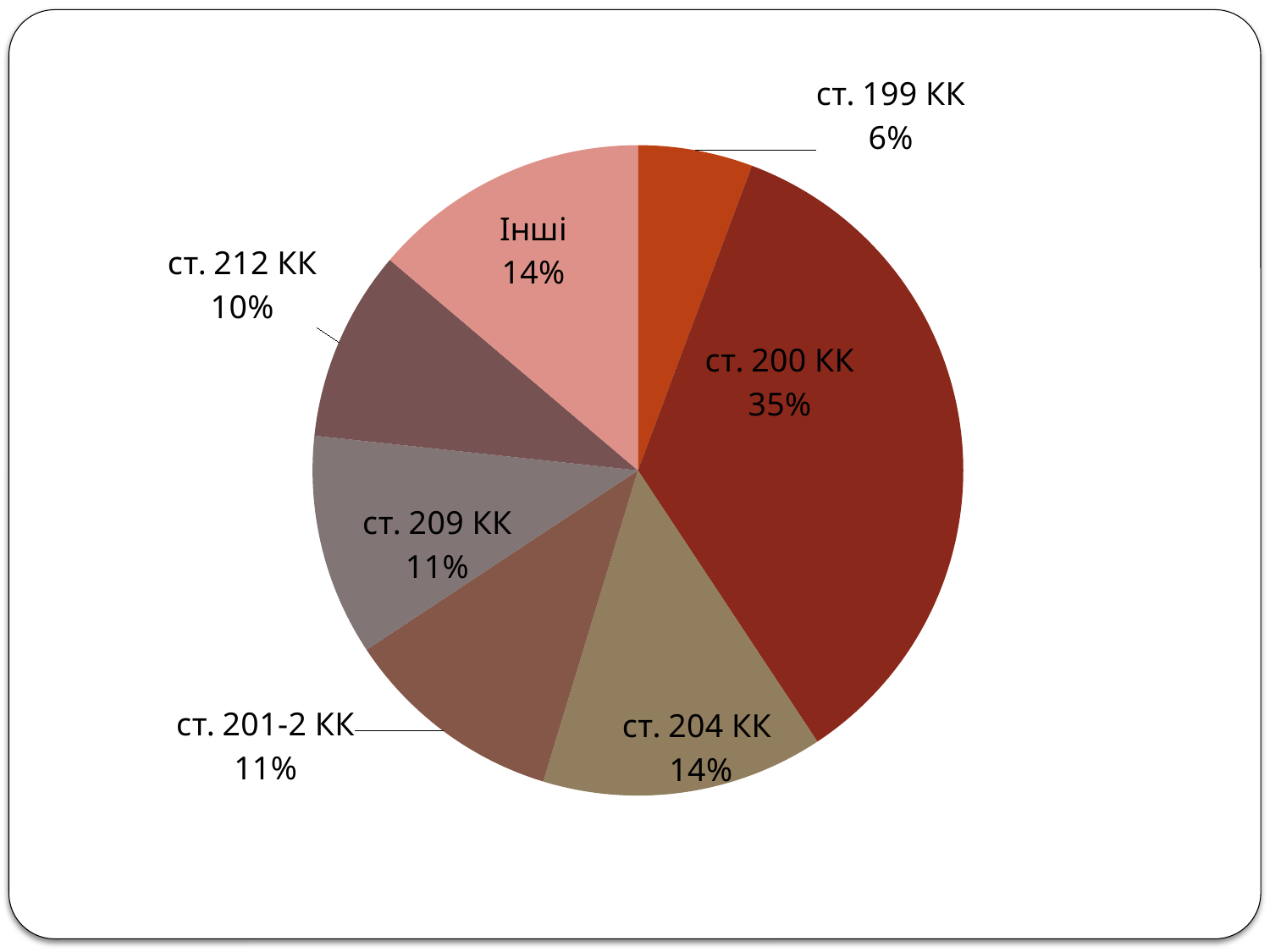
What share of the pie does ст. 212 КК have? 10% What kind of chart is shown on the slide? pie chart Which is larger, the share of Інші or the share of ст. 199 КК? Інші Which slice of the pie is the largest? ст. 200 КК What is the difference between the shares of ст. 201-2 КК and ст. 199 КК? 5% Which is larger, the share of ст. 209 КК or the share of ст. 212 КК? ст. 209 КК What share of the pie does Інші have? 14% What share of the pie does ст. 199 КК have? 6% How many slices does the pie chart have? 7 Which slice of the pie is the smallest? ст. 199 КК What is the difference between the shares of ст. 200 КК and ст. 204 КК? 21%